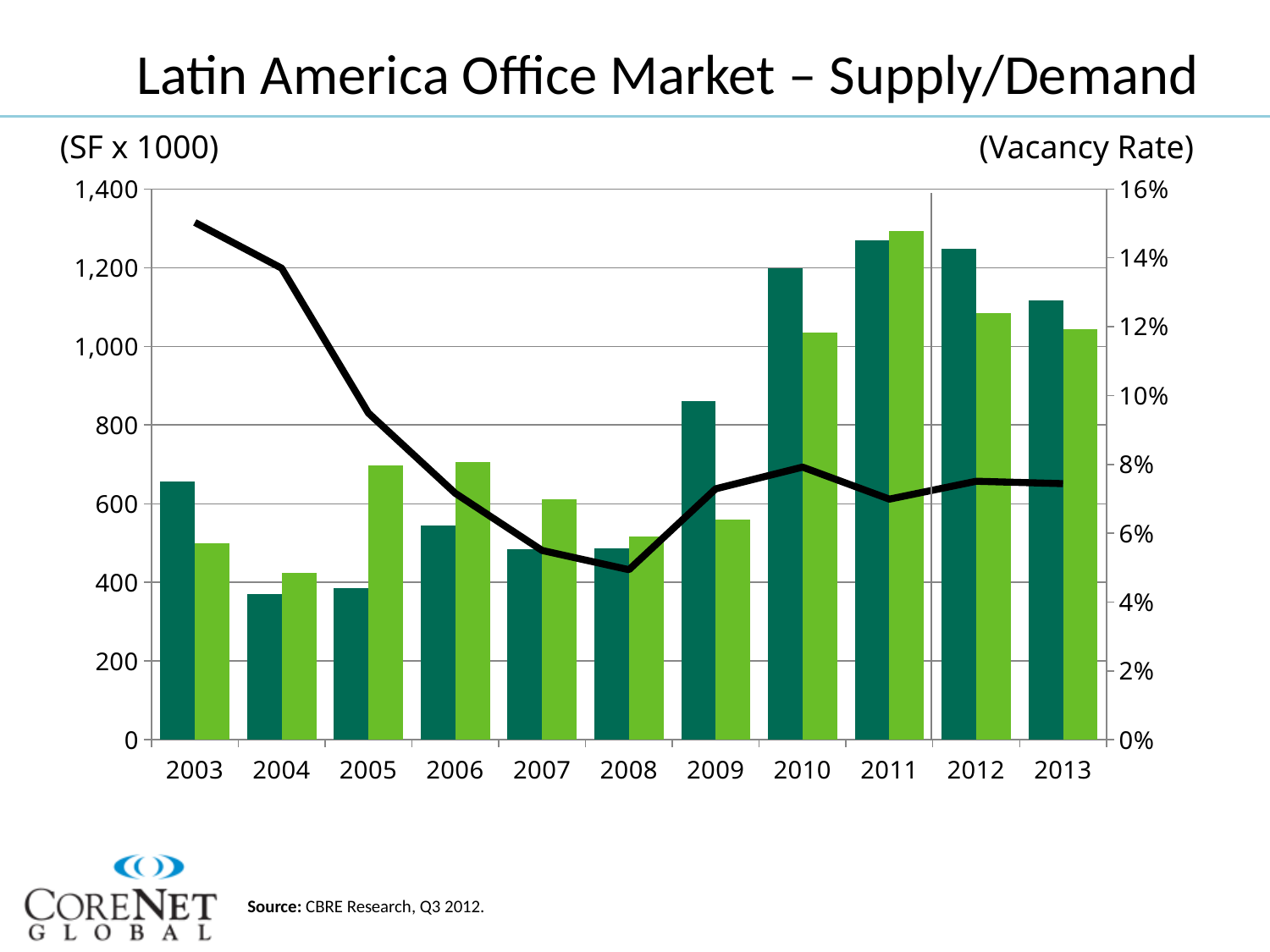
In which year is the light green bar the lowest? 2004 How many years are shown on the x axis of the chart? 11 For 2005, which bar is taller, the dark green bar or the light green bar? The light green bar What unit label is shown above the left axis of the chart? (SF x 1000) Does the vacancy rate line rise or fall from 2003 to 2008? It falls Is the vacancy rate for 2003 greater or less than 14%? greater In which year is the vacancy rate line at its highest? 2003 In which year is the light green bar the highest? 2011 Is the vacancy rate for 2008 greater or less than 6%? less What kind of chart is shown on the slide? A bar chart combined with a line Is the value of the dark green bar for 2010 greater or less than 1,000? greater